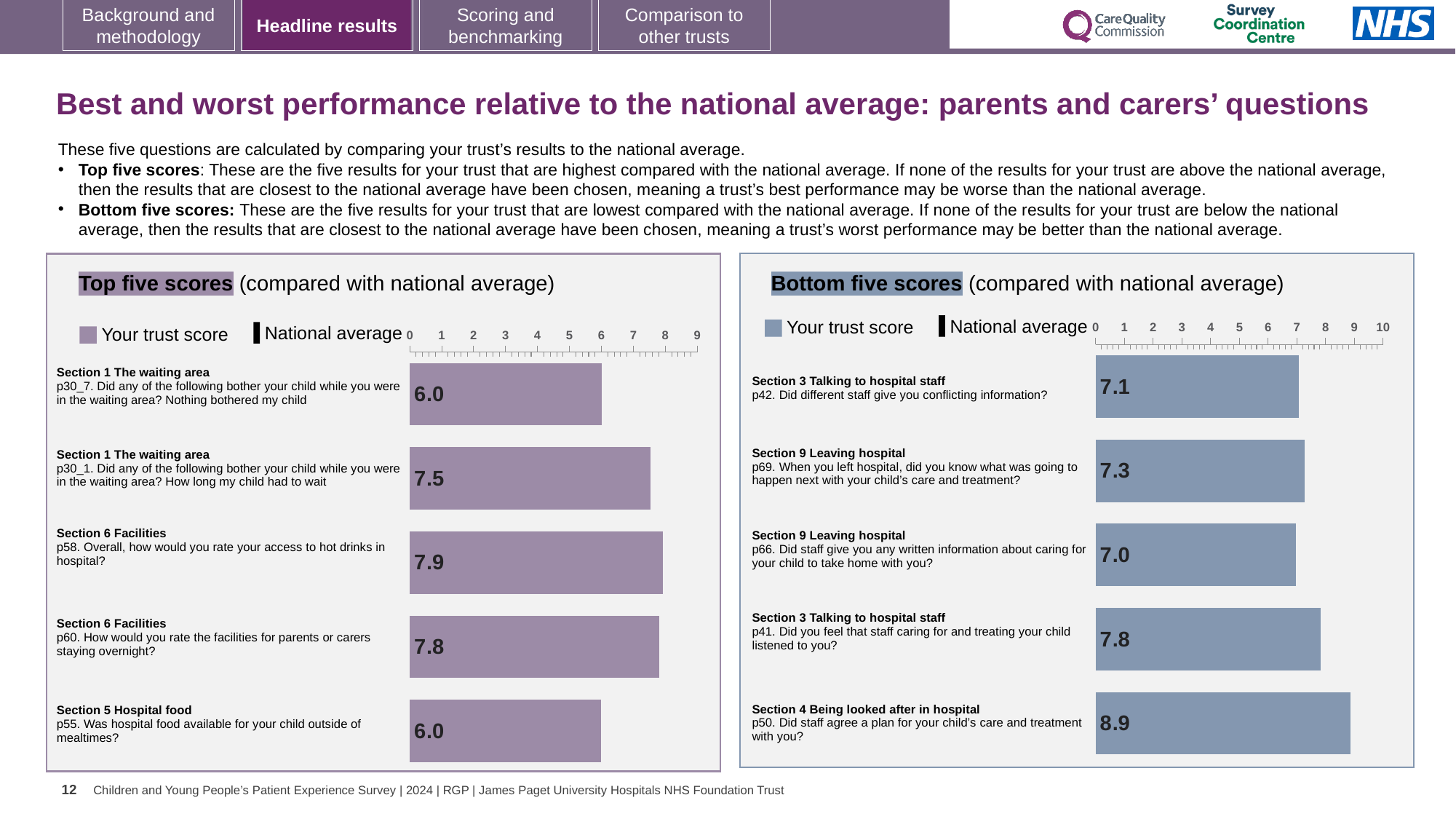
In the Bottom five scores chart, which has the larger trust score: p69 or p41? p41 In the Top five scores chart, what is the difference between the trust scores for p58 and p55? 1.9 In the Top five scores chart, which question has the highest trust score? p58. Overall, how would you rate your access to hot drinks in hospital? How many questions are shown in the Bottom five scores chart? 5 In the Bottom five scores chart, what is the trust score for p50 (did staff agree a plan for your child's care and treatment with you)? 8.9 In the Bottom five scores chart, which question has the lowest trust score? p66. Did staff give you any written information about caring for your child to take home with you? In the Bottom five scores chart, what is the difference between the trust scores for p50 and p42? 1.8 How many entries does the legend of the Top five scores chart list? 2 In the Bottom five scores chart, what is the trust score for p66 (written information about caring for your child to take home)? 7.0 In the Top five scores chart, what is the trust score for p58 (access to hot drinks in hospital)? 7.9 In the Top five scores chart, what is the trust score for p30_1 (how long my child had to wait)? 7.5 What type of chart is the Top five scores chart? Bar chart